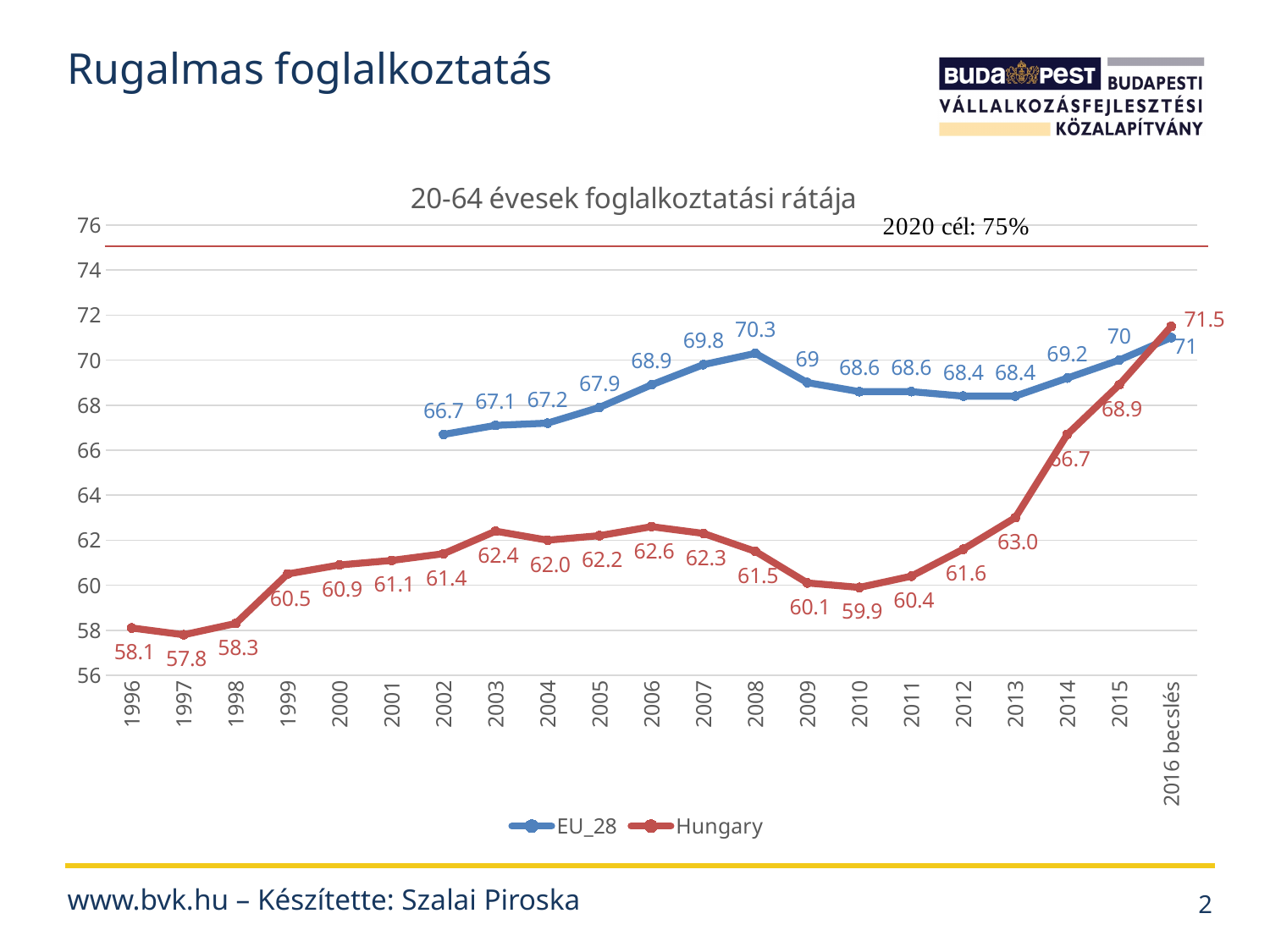
What is the Hungary value for 2016 becslés? 71.5 How many points are plotted for the Hungary series? 21 How many series does the legend list? 2 What type of chart is shown on the slide? line chart What is the EU_28 value for 2008? 70.3 Does the Hungary series rise or fall from 2013 to 2016 becslés? rise Which series has the higher value in 2016 becslés, EU_28 or Hungary? Hungary In which year is the EU_28 series highest? 2016 becslés What is the difference between the EU_28 and Hungary values in 2010? 8.7 What target value is marked by the horizontal line labelled '2020 cél'? 75% What is the Hungary value for 2013? 63.0 In which year is the Hungary series lowest? 1997